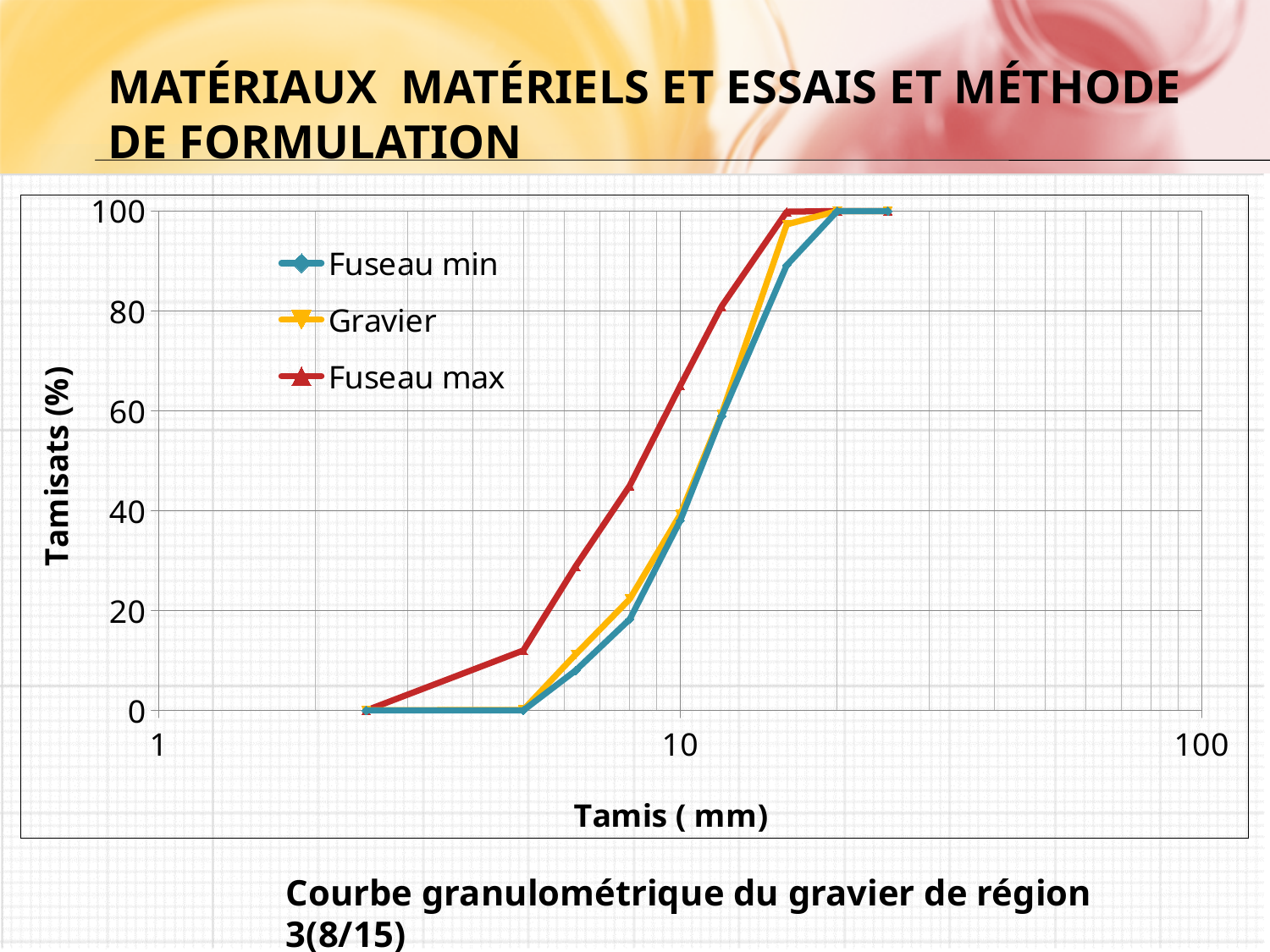
At a sieve size of 5 mm, is the value for Fuseau max greater or less than 20? less What kind of chart is shown on the slide? line chart What is the title of the y axis? Tamisats (%) At a sieve size of 10 mm, which of the three series has the highest value? Fuseau max Do the values of the Gravier series rise or fall as the sieve size (Tamis) increases along the x axis? rise At a sieve size of 10 mm, is the value for Fuseau max greater or less than 60? greater What are the names of the series listed in the legend? Fuseau min, Gravier, Fuseau max What is the maximum value reached by the Fuseau max series? 100 At a sieve size of 10 mm, which series has the larger value, Fuseau max or Fuseau min? Fuseau max How many series does the legend list? 3